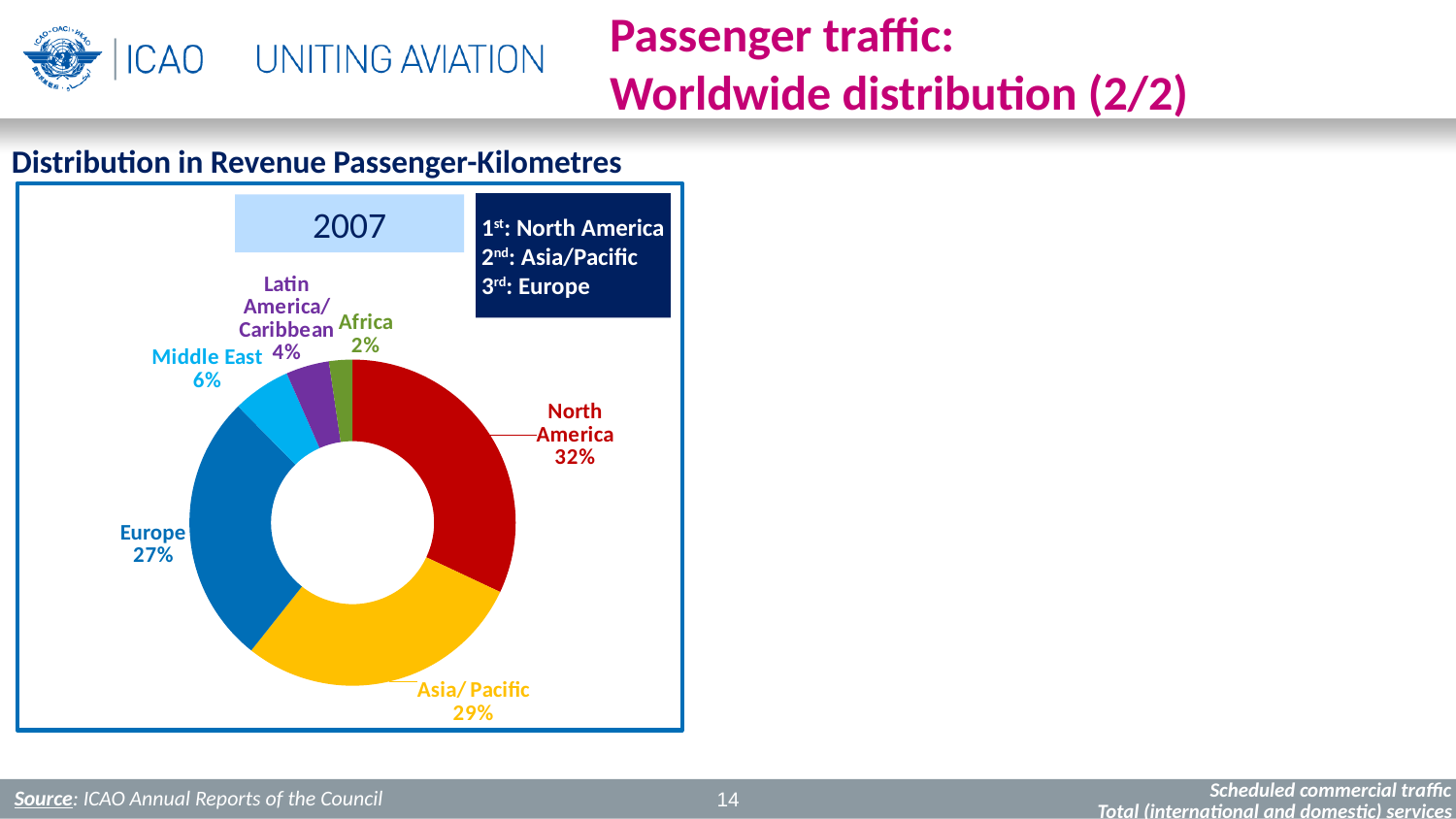
Which year does the chart represent? 2007 What percentage is shown for Africa? 2% What kind of chart is shown on the slide? Doughnut (pie) chart What is the difference in percentage points between North America and Europe? 5 percentage points What share of revenue passenger-kilometres does North America have in 2007? 32% What share does Asia/Pacific have in the 2007 chart? 29% Which region has the smallest share? Africa What is the value shown for Europe? 27% What percentage is shown for the Middle East? 6% Which region has the largest share of revenue passenger-kilometres? North America How many regions are shown in the chart? 6 Which is larger, the share for Asia/Pacific or the share for Europe? Asia/Pacific